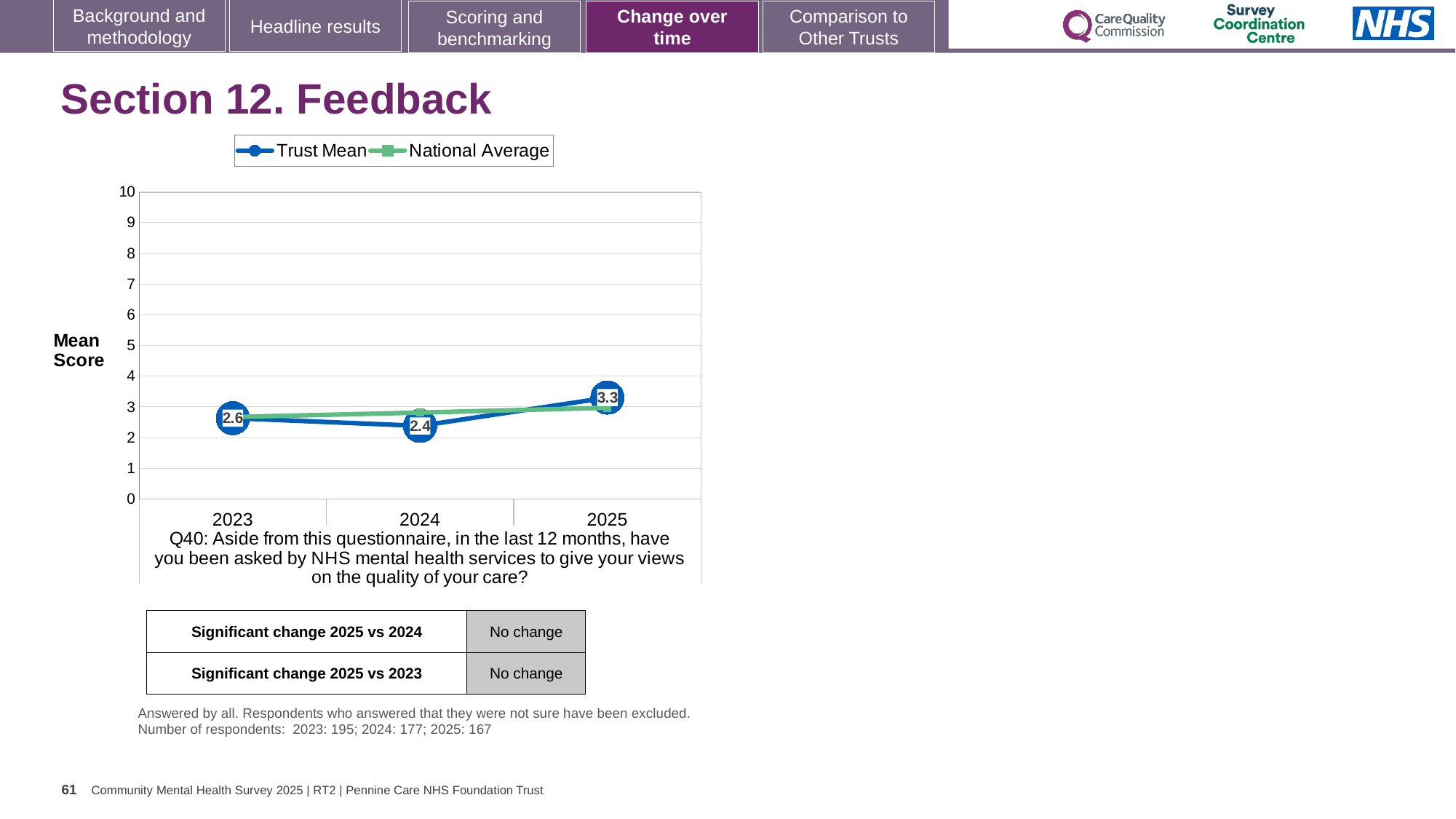
What is the difference between the Trust Mean scores for 2025 and 2024? 0.9 What is the Trust Mean score for 2025? 3.3 Which year has the larger Trust Mean score, 2023 or 2025? 2025 What kind of chart is shown on the slide? Line chart How many series does the chart legend list? 2 What is the Trust Mean score for 2023? 2.6 How many years are shown on the x axis of the chart? 3 What is the Trust Mean score for 2024? 2.4 Between 2024 and 2025, does the Trust Mean score rise or fall? rise Is the National Average for 2025 greater or less than 4? less In which year is the Trust Mean score highest? 2025 In which year is the Trust Mean score lowest? 2024